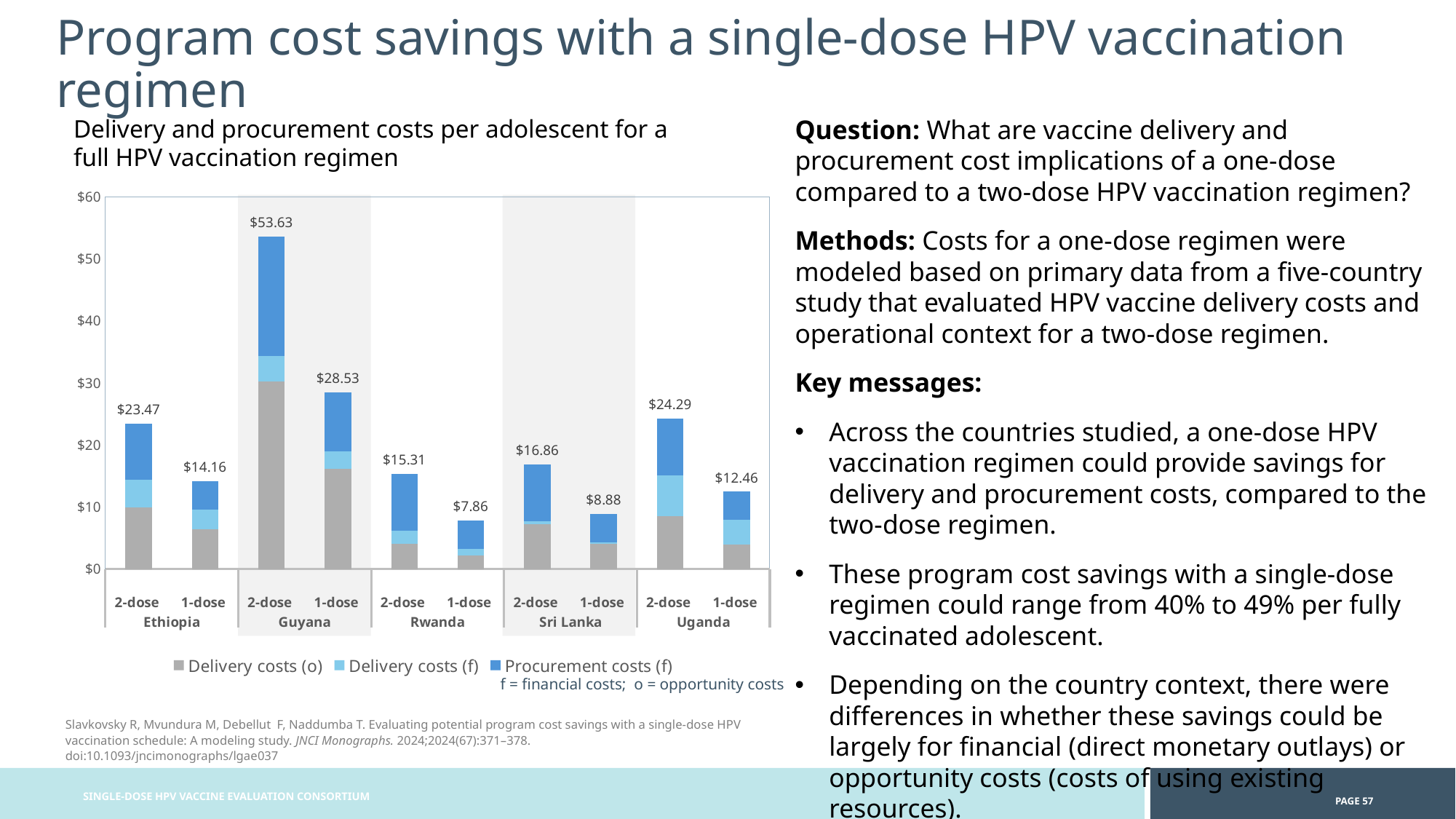
How many bars are plotted in the chart? 10 What is the total cost per adolescent for the 1-dose regimen in Ethiopia? $14.16 Which bar has the lowest total cost per adolescent? Rwanda 1-dose Which is larger, the 2-dose total cost in Ethiopia or the 2-dose total cost in Uganda? Uganda 2-dose What kind of chart is shown on the slide? Stacked bar chart What is the difference between the 2-dose and 1-dose total costs in Uganda? $11.83 What is the difference between the 2-dose and 1-dose total costs in Guyana? $25.10 How many series does the legend list? 3 What is the total cost per adolescent for the 2-dose regimen in Guyana? $53.63 Which bar has the highest total cost per adolescent? Guyana 2-dose What is the total cost per adolescent for the 1-dose regimen in Sri Lanka? $8.88 Is the Delivery costs (o) value for the Uganda 2-dose bar greater or less than $10? less